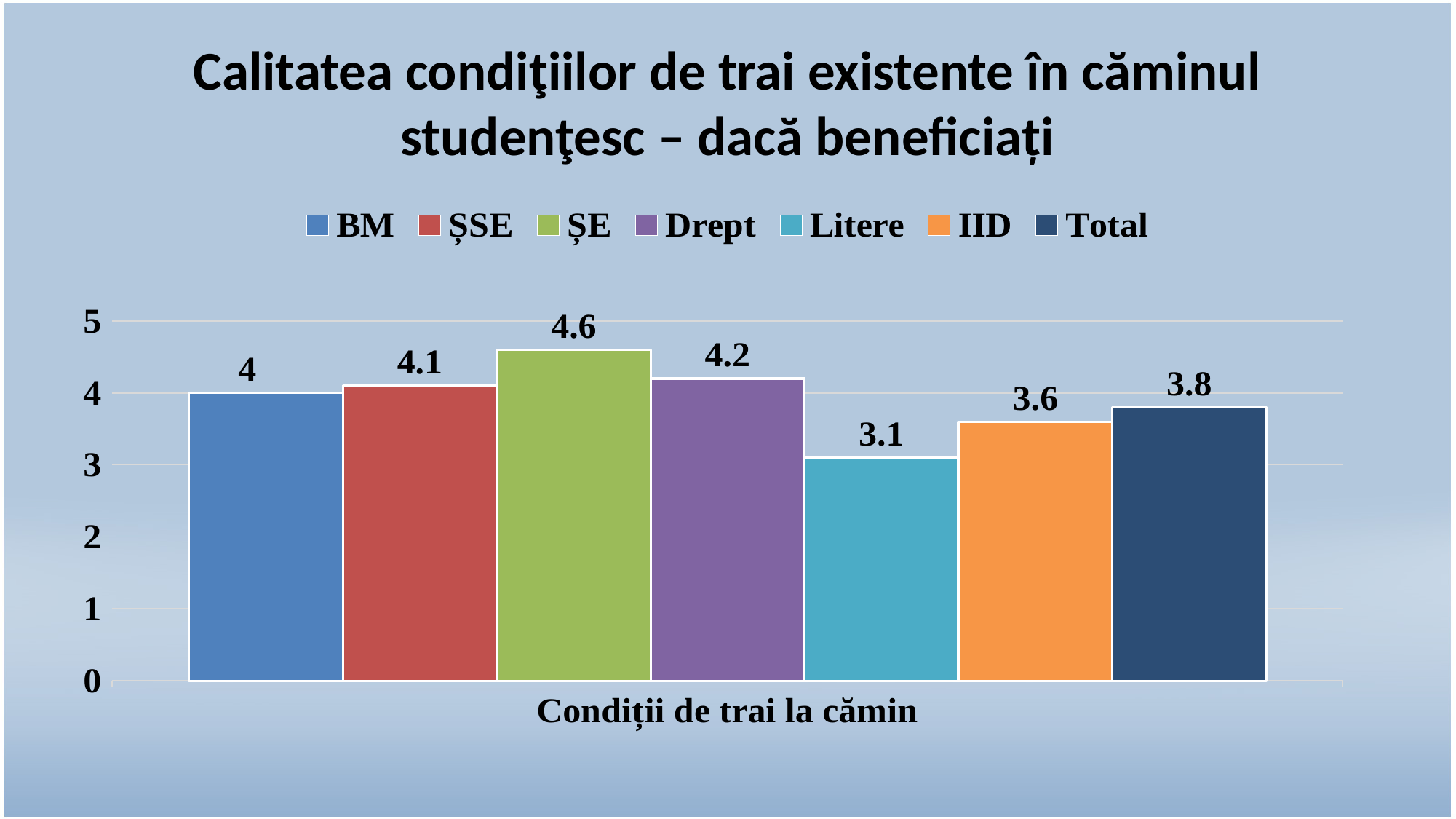
What is the value for Total? 3.8 Which is larger, the value for ȘSE or the value for IID? ȘSE What is the value for ȘE? 4.6 Which series has the highest value? ȘE How many series does the legend list? 7 What kind of chart is shown on the slide? Bar chart Which series has the lowest value? Litere What is the difference between the values for ȘE and Litere? 1.5 What is the label on the horizontal axis? Condiții de trai la cămin What is the difference between the values for Drept and BM? 0.2 What is the value for Litere? 3.1 What is the value for IID? 3.6